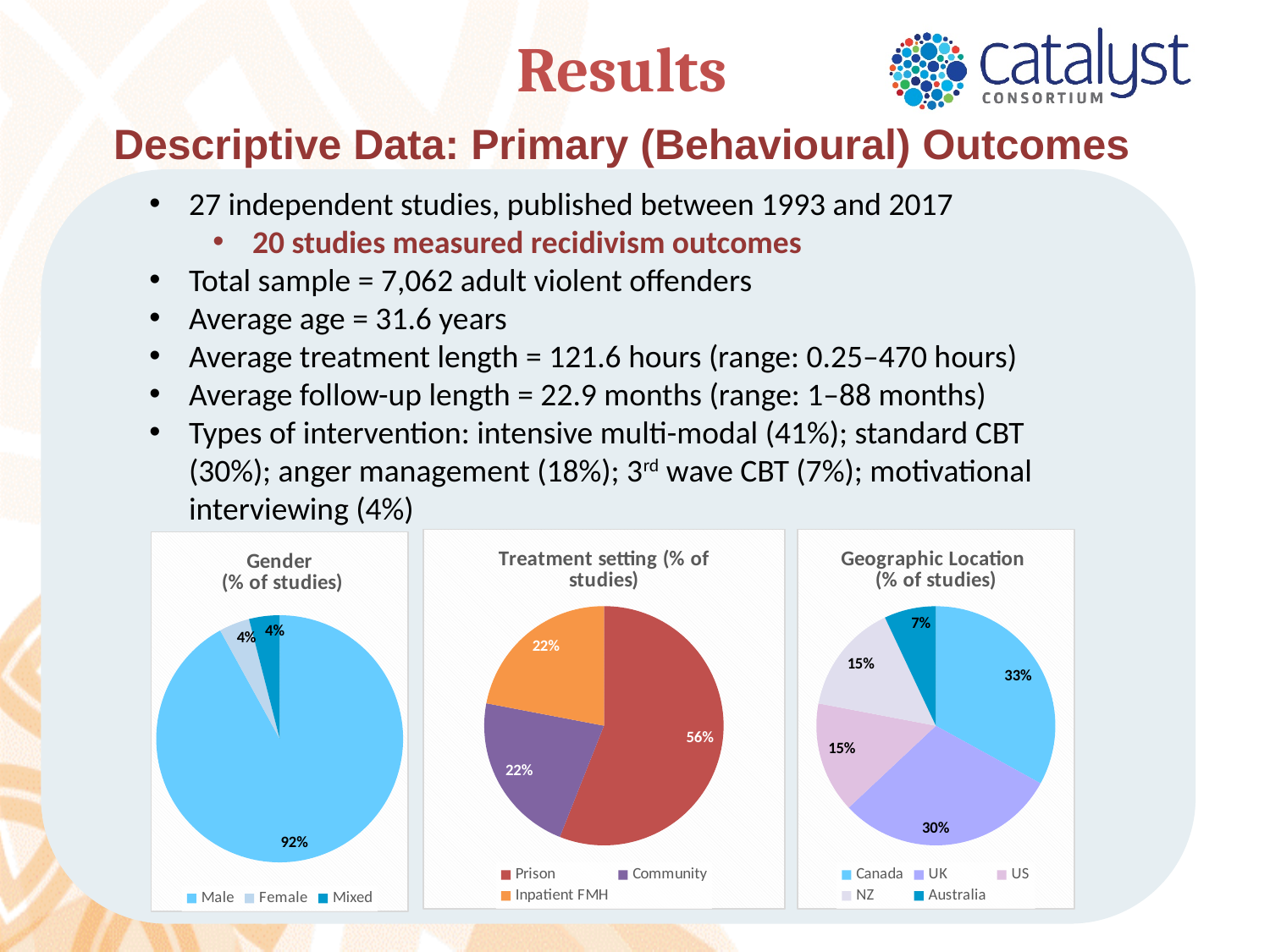
How many categories does the Treatment setting pie chart show? 3 In the Geographic Location pie chart, which location has the smallest share? Australia How many categories does the Geographic Location pie chart legend list? 5 In the Gender pie chart, what percentage of studies are Mixed? 4% In the Treatment setting pie chart, what percentage of studies were in Inpatient FMH? 22% In the Geographic Location pie chart, which is larger, the share for Canada or the share for UK? Canada In the Treatment setting pie chart, what percentage of studies were in Prison? 56% In the Treatment setting pie chart, what is the difference between the Prison and Community shares? 34% What type of chart is the Geographic Location chart? Pie chart In the Gender pie chart, which category has the largest share? Male In the Gender pie chart, what percentage of studies are Male? 92% In the Geographic Location pie chart, what percentage of studies are from Canada? 33%